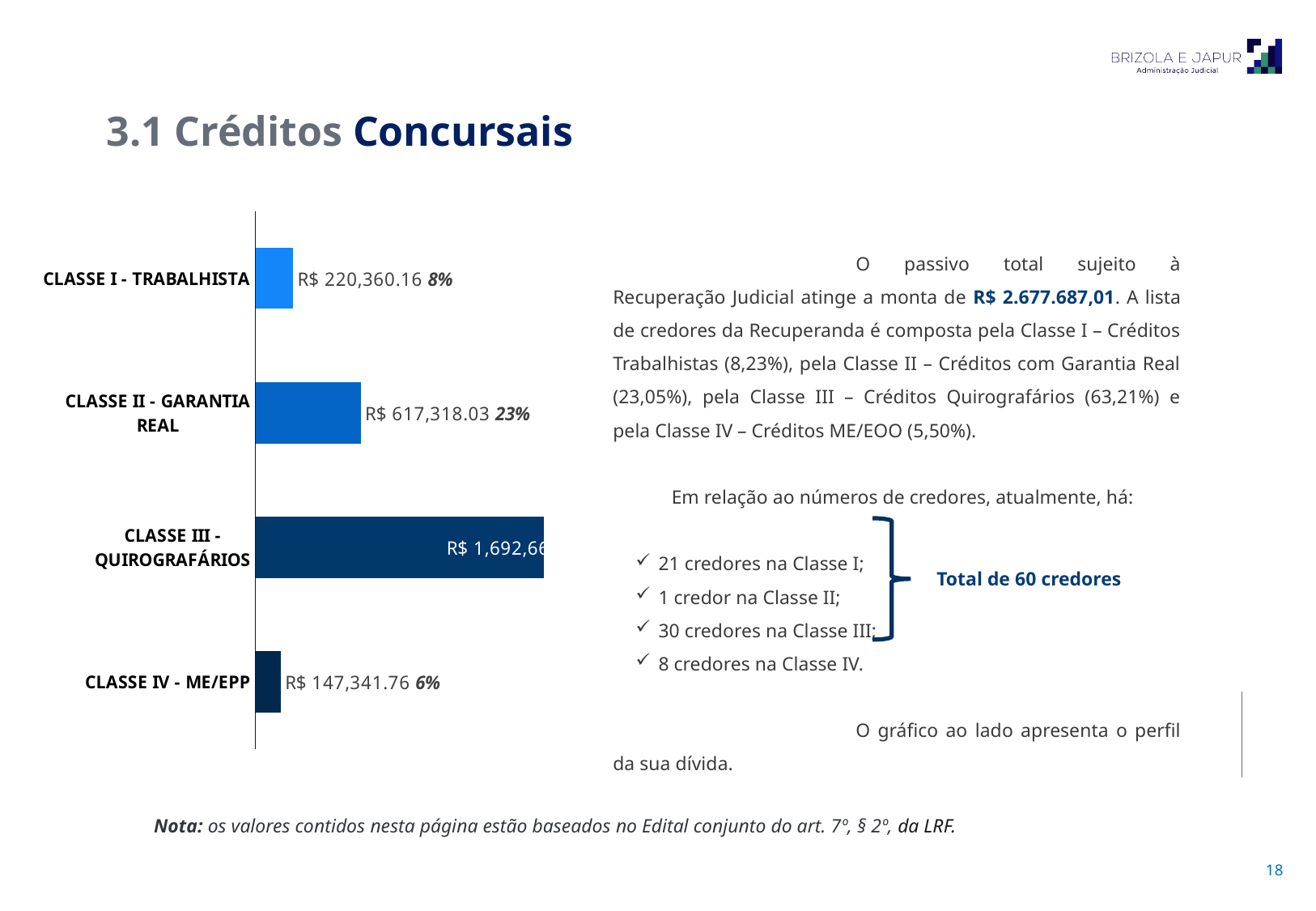
What kind of chart is shown on the slide? Bar chart What percentage is shown next to the bar for CLASSE II - GARANTIA REAL? 23% What is the difference between the values for CLASSE II - GARANTIA REAL and CLASSE I - TRABALHISTA? R$ 396,957.87 Which is larger, the value for CLASSE I - TRABALHISTA or for CLASSE IV - ME/EPP? CLASSE I - TRABALHISTA Which class has the largest bar in the chart? CLASSE III - QUIROGRAFÁRIOS What is the value shown for CLASSE I - TRABALHISTA? R$ 220,360.16 What is the value shown for CLASSE IV - ME/EPP? R$ 147,341.76 What percentage is shown next to the bar for CLASSE IV - ME/EPP? 6% Which class has the smallest bar in the chart? CLASSE IV - ME/EPP What is the difference between the values for CLASSE I - TRABALHISTA and CLASSE IV - ME/EPP? R$ 73,018.40 What is the value shown for CLASSE II - GARANTIA REAL? R$ 617,318.03 How many classes (categories) are plotted in the chart? 4